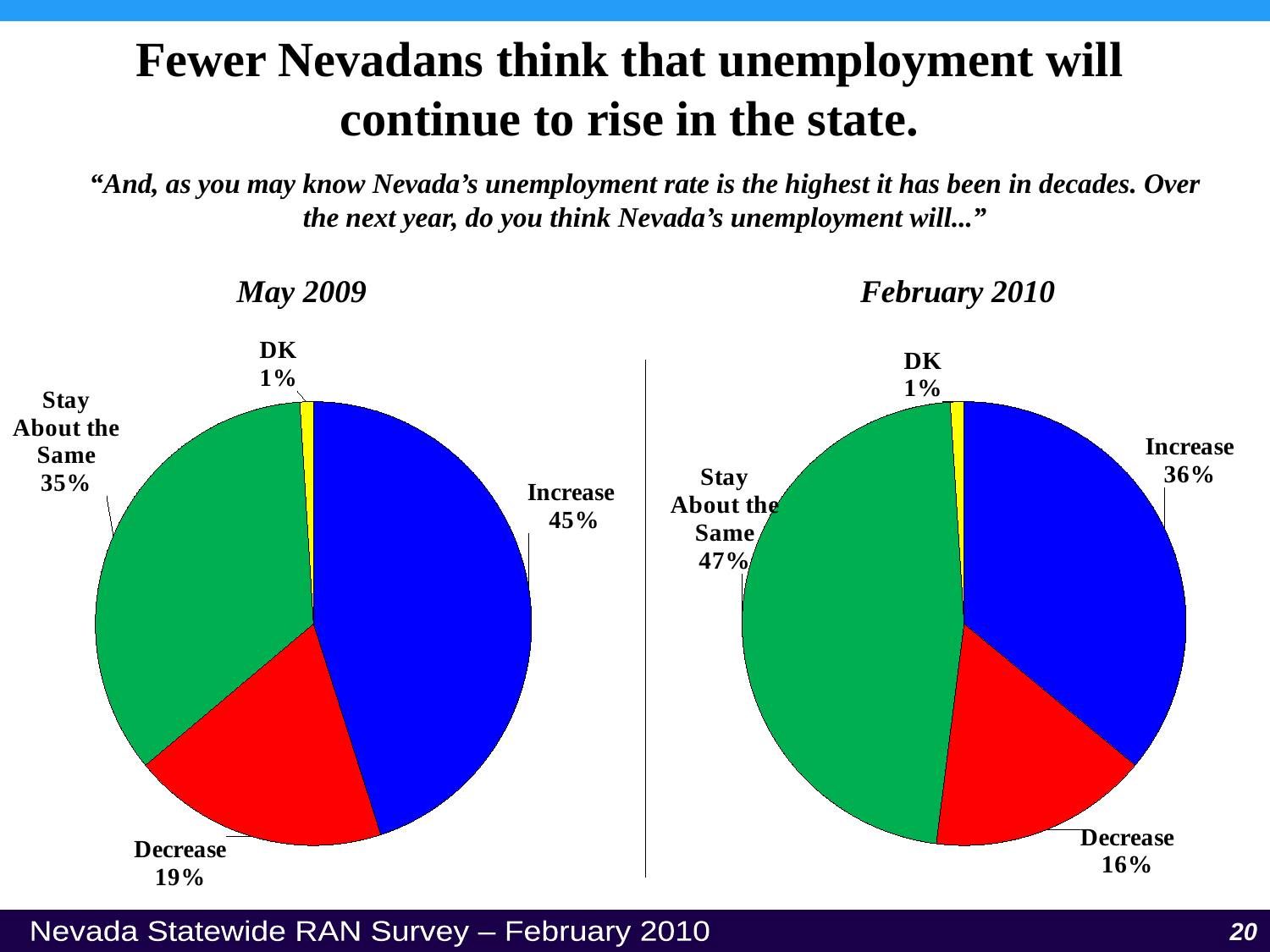
In the February 2010 pie chart, which is larger: Stay About the Same or Increase? Stay About the Same What is the title of the pie chart on the right side of the slide? February 2010 How many slices does the May 2009 pie chart have? 4 In the May 2009 pie chart, what percentage of respondents said unemployment will Increase? 45% What colour is the Decrease slice in both pie charts? Red What type of chart is used on this slide? Pie chart In the February 2010 pie chart, what percentage of respondents said unemployment will Decrease? 16% In the May 2009 pie chart, what is the combined share of Decrease and Stay About the Same? 54% What is the difference between the Increase share in May 2009 and the Increase share in February 2010? 9% In the May 2009 pie chart, which response has the largest share? Increase In the February 2010 pie chart, what percentage of respondents said unemployment will Stay About the Same? 47% In the February 2010 pie chart, which response has the smallest share? DK